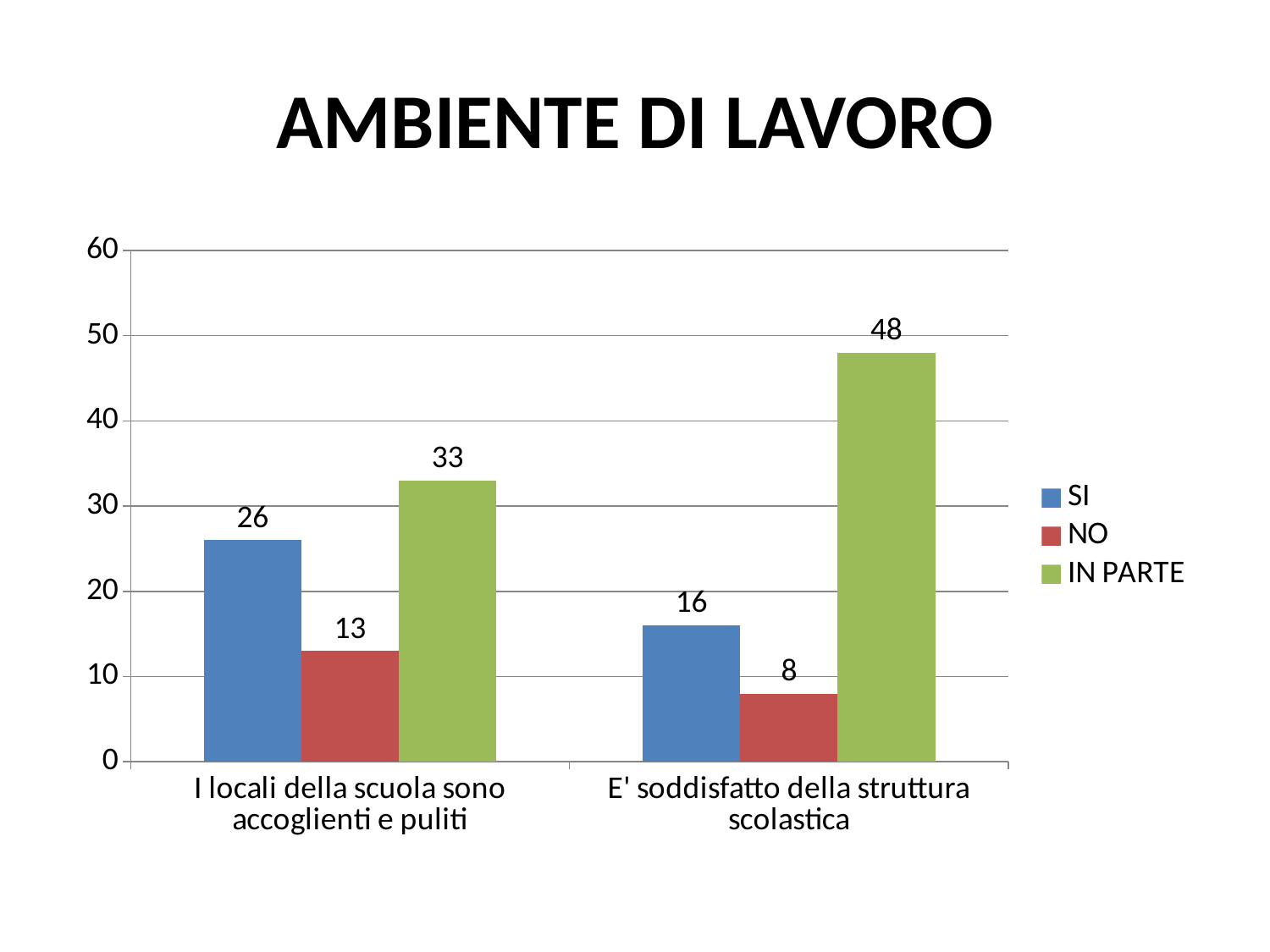
What is the difference between the IN PARTE values for the two categories? 15 What kind of chart is shown on the slide? bar chart Which series has the highest value for "I locali della scuola sono accoglienti e puliti"? IN PARTE What is the value of NO for "E' soddisfatto della struttura scolastica"? 8 What is the difference between SI and NO for "I locali della scuola sono accoglienti e puliti"? 13 What is the value of SI for "I locali della scuola sono accoglienti e puliti"? 26 What is the value of IN PARTE for "E' soddisfatto della struttura scolastica"? 48 How many categories are shown on the x axis? 2 How many series does the legend list? 3 Which is larger: SI for "I locali della scuola sono accoglienti e puliti" or SI for "E' soddisfatto della struttura scolastica"? I locali della scuola sono accoglienti e puliti Which series has the lowest value for "E' soddisfatto della struttura scolastica"? NO What is the title of the slide? AMBIENTE DI LAVORO